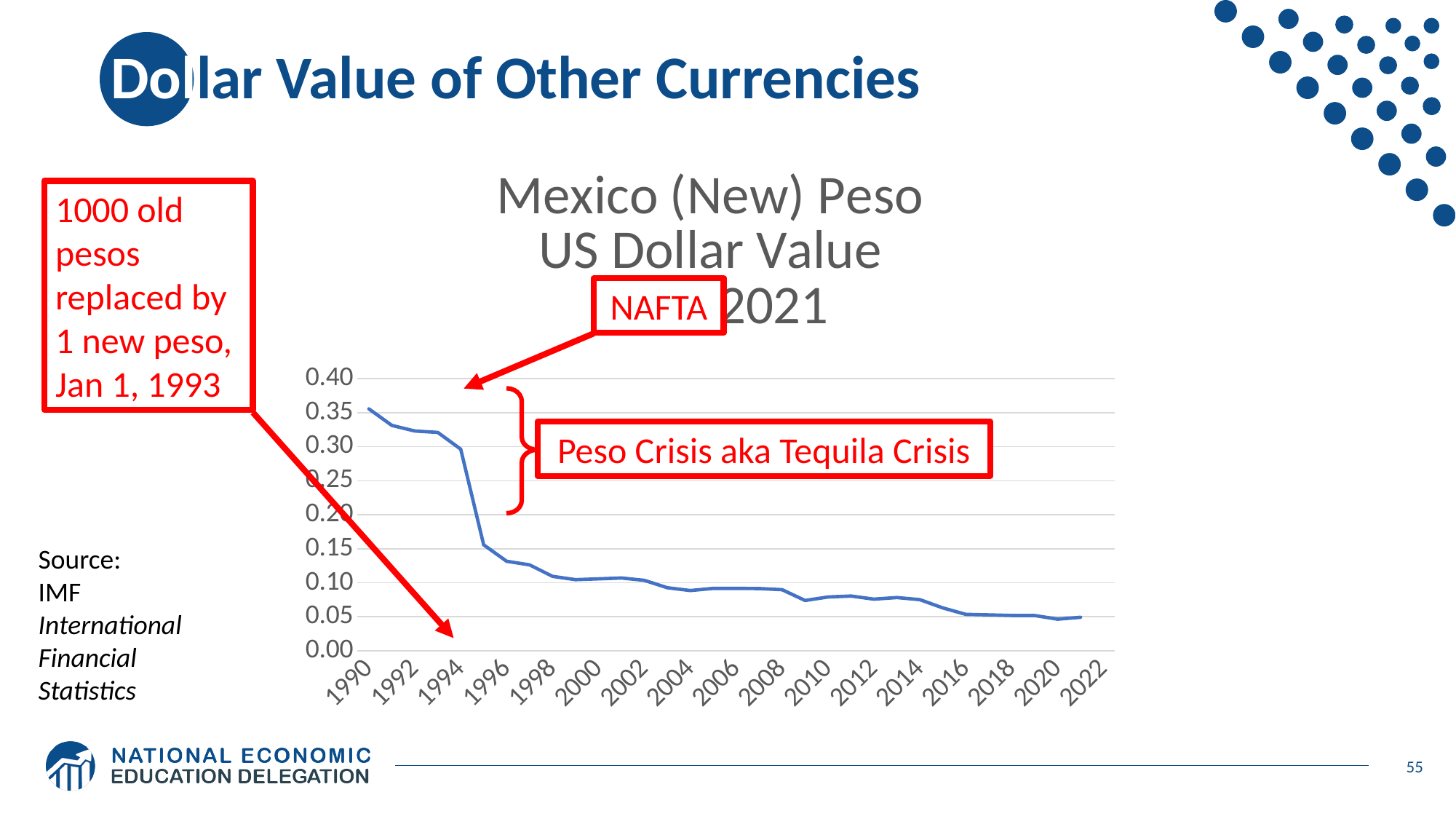
Is the value for 2000 greater or less than 0.15? less Is the value for 1990 greater or less than 0.30? greater What kind of chart is shown on the slide? line chart Is the value for 2020 greater or less than 0.10? less How many year labels are shown on the x axis? 17 Which year has a higher US dollar value of the peso, 2008 or 2016? 2008 What is the title of the chart? Mexico (New) Peso US Dollar Value 1990-2021 Which year has a higher US dollar value of the peso, 1994 or 1996? 1994 In which year shown is the US dollar value of the peso highest? 1990 What event does the red annotation label the sharp drop in the peso's value after 1994? Peso Crisis aka Tequila Crisis Overall, does the US dollar value of the Mexican peso rise or fall from 1990 to 2021? fall